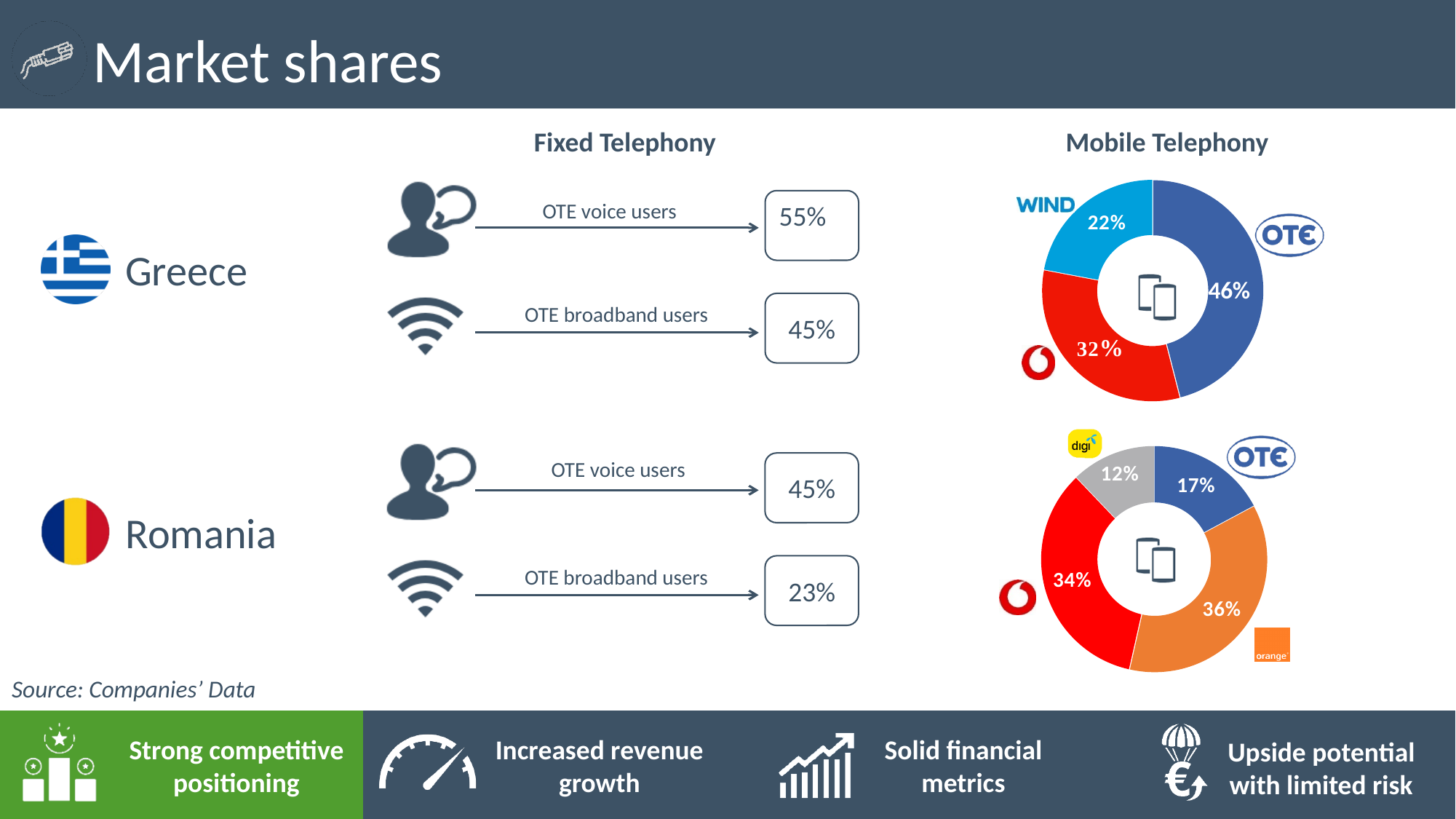
In the Romania Mobile Telephony donut chart, what market share does Orange hold? 36% In the Greece Mobile Telephony donut chart, which operator has the smallest share? WIND In the Romania Mobile Telephony donut chart, what market share does OTE hold? 17% How many segments does the Romania Mobile Telephony donut chart have? 4 How many segments does the Greece Mobile Telephony donut chart have? 3 In the Greece Mobile Telephony donut chart, what market share does WIND hold? 22% In the Greece Mobile Telephony donut chart, which operator has the largest share? OTE In the Greece Mobile Telephony donut chart, what market share does OTE hold? 46% In the Romania Mobile Telephony donut chart, which operator has the largest share? Orange What type of chart is used to show Mobile Telephony market shares on the slide? Donut (pie) chart In the Romania Mobile Telephony donut chart, which operator has the smallest share? digi In the Greece Mobile Telephony donut chart, what is the difference between OTE's share and WIND's share? 24%